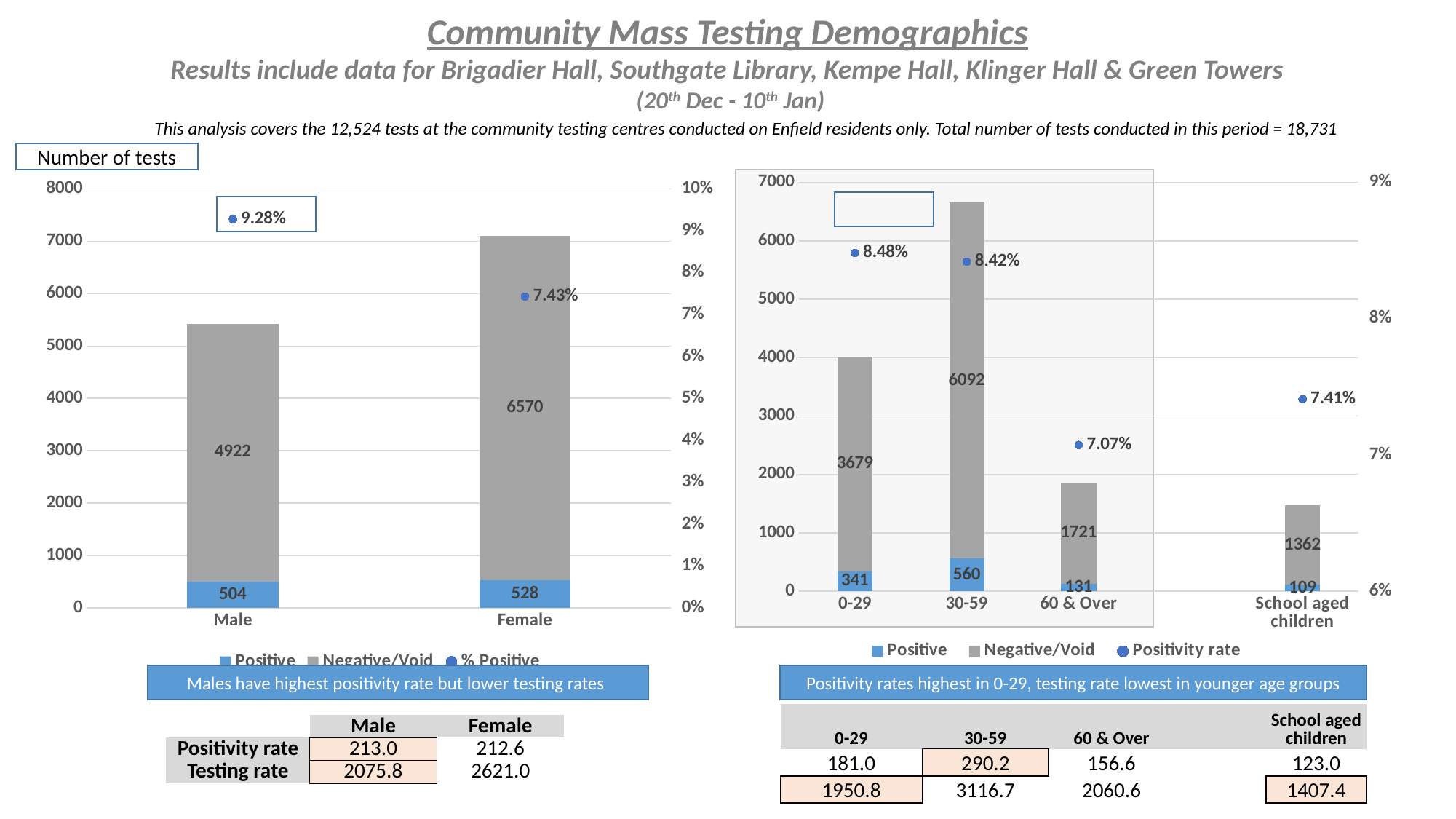
In the left chart (Male/Female), what is the total of the stacked bar for Female? 7098 In the left chart (Male/Female), what is the difference between the Positive values for Female and Male? 24 In the right chart (age groups), which age group has the highest Positive value? 30-59 In the right chart (age groups), which age group has the lowest Positivity rate? 60 & Over In the right chart (age groups), what is the Positivity rate for 60 & Over? 7.07% In the left chart (Male/Female), what is the % Positive value for Female? 7.43% In the left chart (Male/Female), which category has the higher % Positive? Male In the left chart (Male/Female), what is the Negative/Void value for Male? 4922 In the right chart (age groups), what is the Negative/Void value for 30-59? 6092 In the right chart (age groups), how many age categories are shown on the x axis? 4 In the right chart (age groups), what is the total of the stacked bar for 0-29? 4020 In the left chart (Male/Female), how many series does the legend list? 3